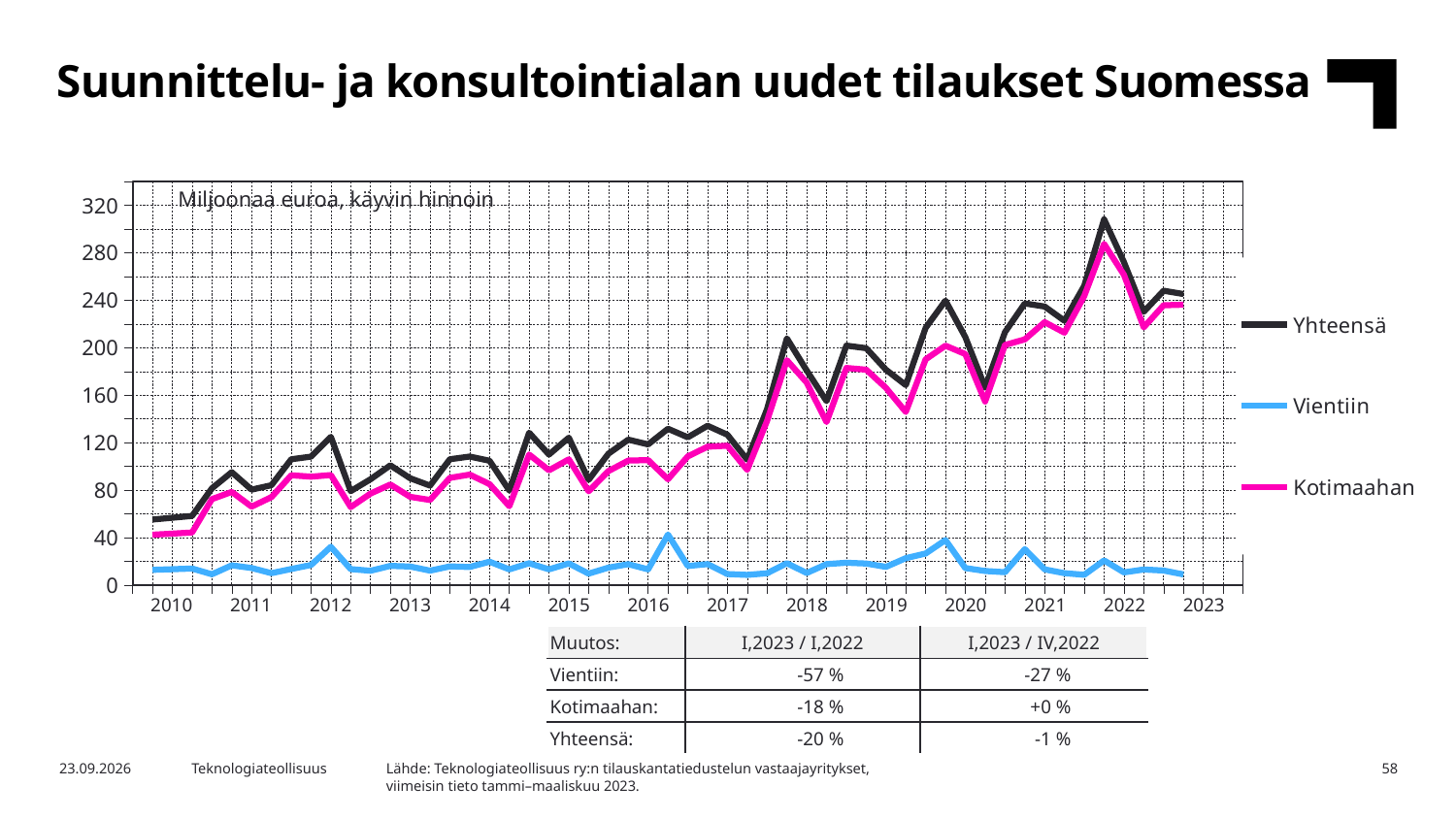
Is the value of the Kotimaahan series at the end of 2022 greater or less than 200? greater Which series has the highest values throughout the chart? Yhteensä Overall, do the Yhteensä values rise or fall from 2010 to 2022? rise Is the value of the Yhteensä series at the start of 2010 greater or less than 80? less Which series has the lowest values throughout the chart? Vientiin How many series does the legend list? 3 Is the value of the Vientiin series at the start of 2010 greater or less than 40? less Which series is larger in 2018, Kotimaahan or Vientiin? Kotimaahan What are the three series named in the legend? Yhteensä, Vientiin, Kotimaahan What kind of chart is shown on the slide? line chart What unit is stated in the label inside the chart area? Miljoonaa euroa, käyvin hinnoin